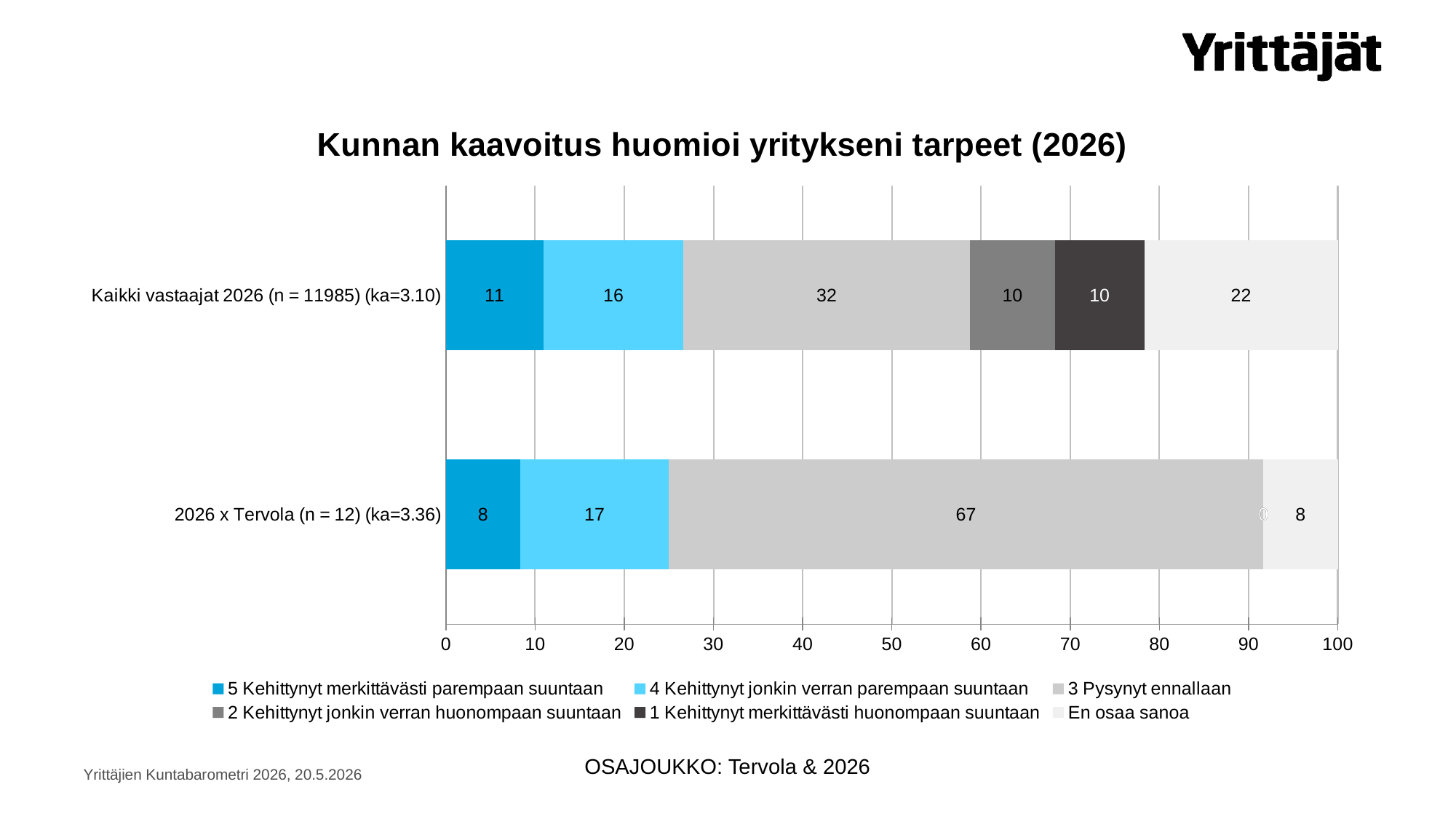
What is the value of '3 Pysynyt ennallaan' for '2026 x Tervola (n = 12) (ka=3.36)'? 67 What is the difference between the '3 Pysynyt ennallaan' values for '2026 x Tervola (n = 12) (ka=3.36)' and 'Kaikki vastaajat 2026 (n = 11985) (ka=3.10)'? 35 Which category has the larger value for '4 Kehittynyt jonkin verran parempaan suuntaan': 'Kaikki vastaajat 2026 (n = 11985) (ka=3.10)' or '2026 x Tervola (n = 12) (ka=3.36)'? 2026 x Tervola (n = 12) (ka=3.36) Which series has the highest value in the 'Kaikki vastaajat 2026 (n = 11985) (ka=3.10)' bar? 3 Pysynyt ennallaan How many series does the legend list? 6 What is the value of 'En osaa sanoa' for 'Kaikki vastaajat 2026 (n = 11985) (ka=3.10)'? 22 How many categories (bars) are shown in the chart? 2 What is the title of the chart? Kunnan kaavoitus huomioi yritykseni tarpeet (2026) What is the value of '5 Kehittynyt merkittävästi parempaan suuntaan' for '2026 x Tervola (n = 12) (ka=3.36)'? 8 What is the value of '3 Pysynyt ennallaan' for 'Kaikki vastaajat 2026 (n = 11985) (ka=3.10)'? 32 What is the value of '4 Kehittynyt jonkin verran parempaan suuntaan' for 'Kaikki vastaajat 2026 (n = 11985) (ka=3.10)'? 16 What type of chart is shown on the slide? stacked bar chart